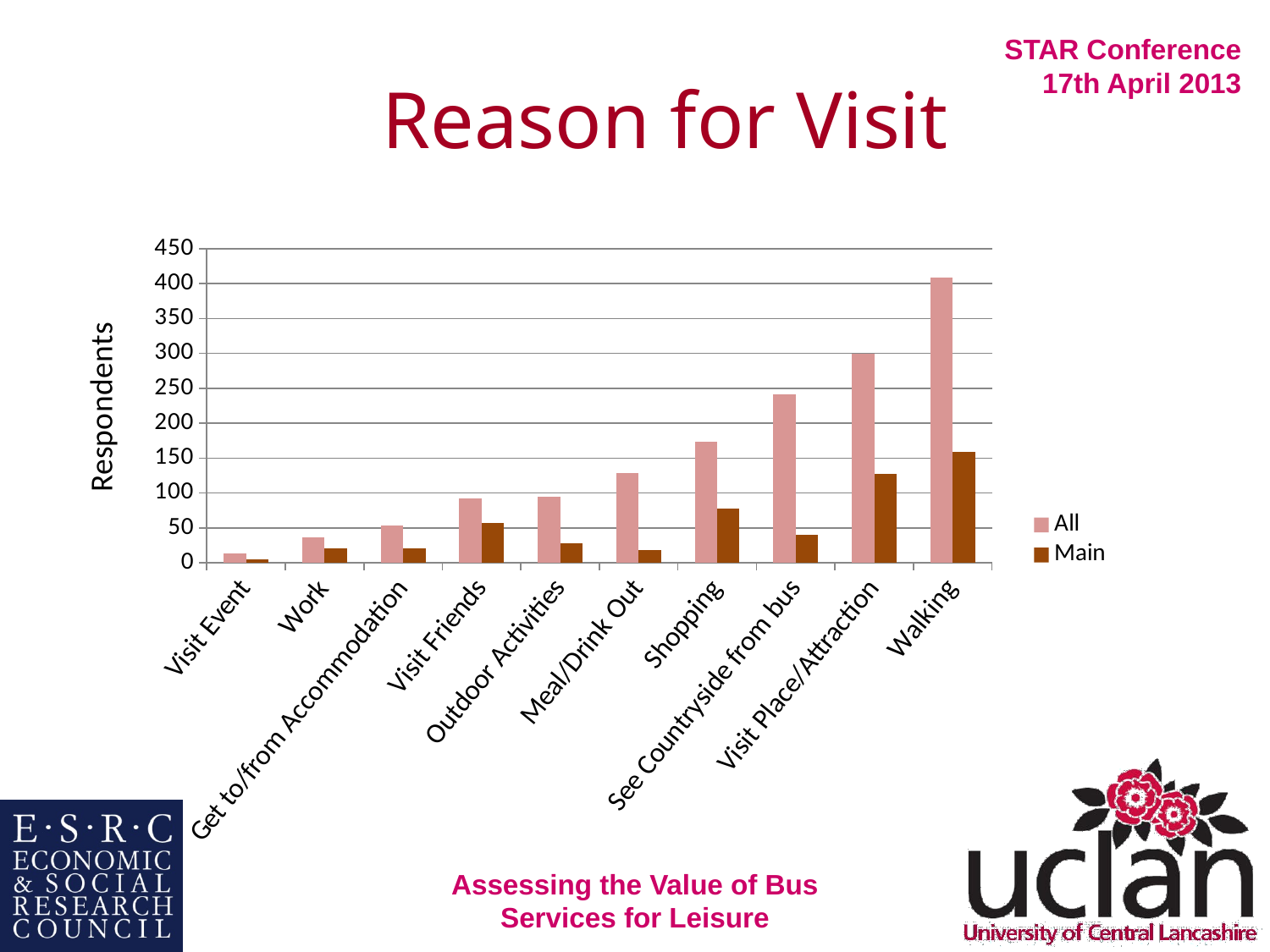
Which category has the highest value for the Main series? Walking What kind of chart is shown on the slide? bar chart How many reason-for-visit categories are shown on the x axis? 10 Is the All value for Shopping greater or less than 150? greater Do the All series values rise or fall moving from left to right along the x axis? rise For the Main series, which is larger: Visit Friends or Outdoor Activities? Visit Friends Which category has the lowest value for the All series? Visit Event How many series does the legend list? 2 Is the All value for Visit Event greater or less than 50? less Is the Main value for Visit Place/Attraction greater or less than 100? greater Which category has the highest value for the All series? Walking